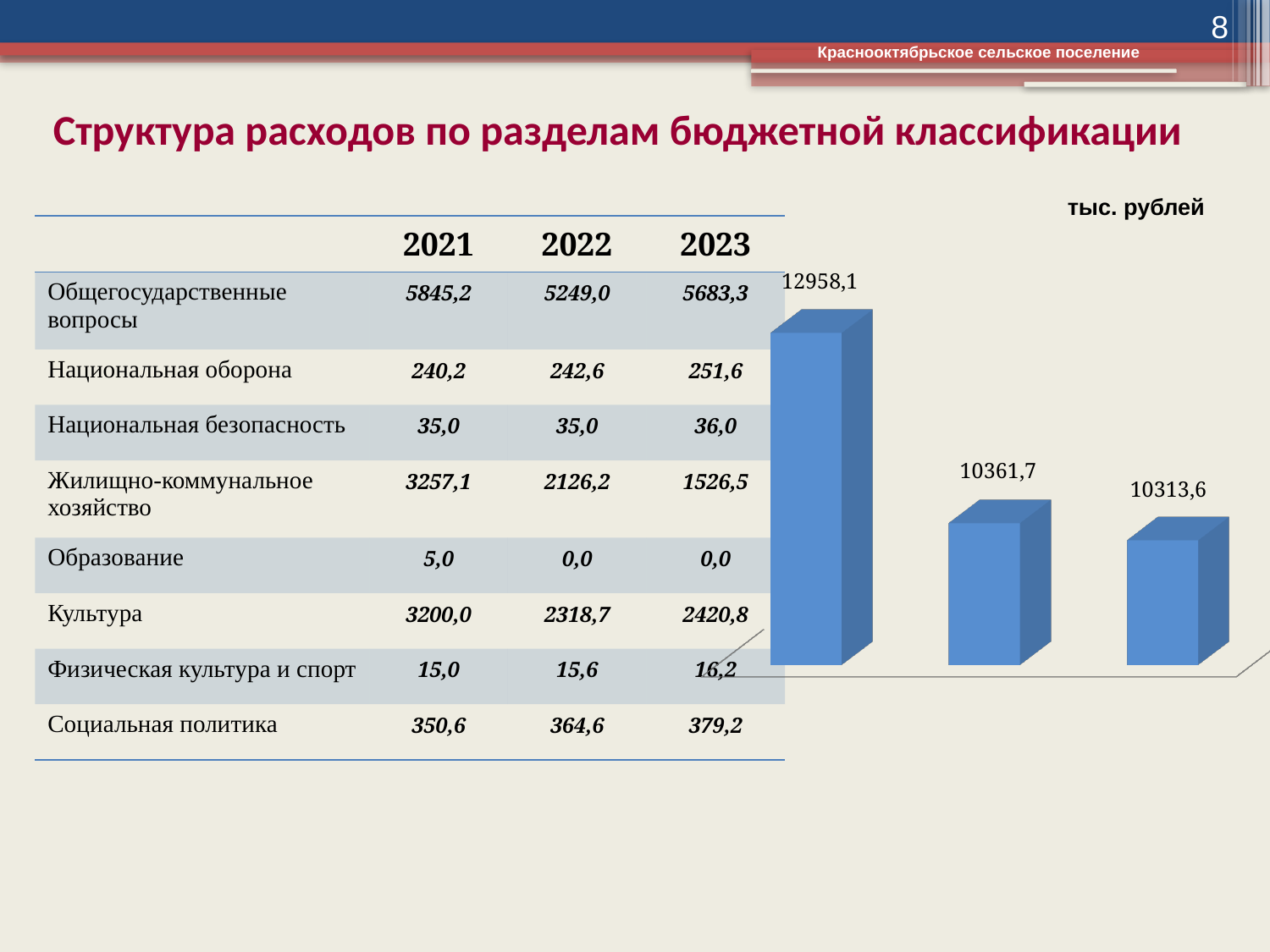
What type of chart is shown on the slide? Bar chart What value is printed on the middle bar of the chart? 10361,7 What is the difference between the middle bar (10361,7) and the rightmost bar (10313,6)? 48,1 Which bar in the chart has the highest value? The leftmost bar (12958,1) What is the difference between the leftmost bar (12958,1) and the middle bar (10361,7)? 2596,4 Do the bar values rise or fall from left to right across the chart? Fall Which bar in the chart has the lowest value? The rightmost bar (10313,6) What unit is indicated above the chart? тыс. рублей What value is printed on the rightmost bar of the chart? 10313,6 What value is printed on the leftmost bar of the chart? 12958,1 How many bars are plotted in the chart? 3 Which is larger, the value of the middle bar or the value of the rightmost bar? The middle bar (10361,7)